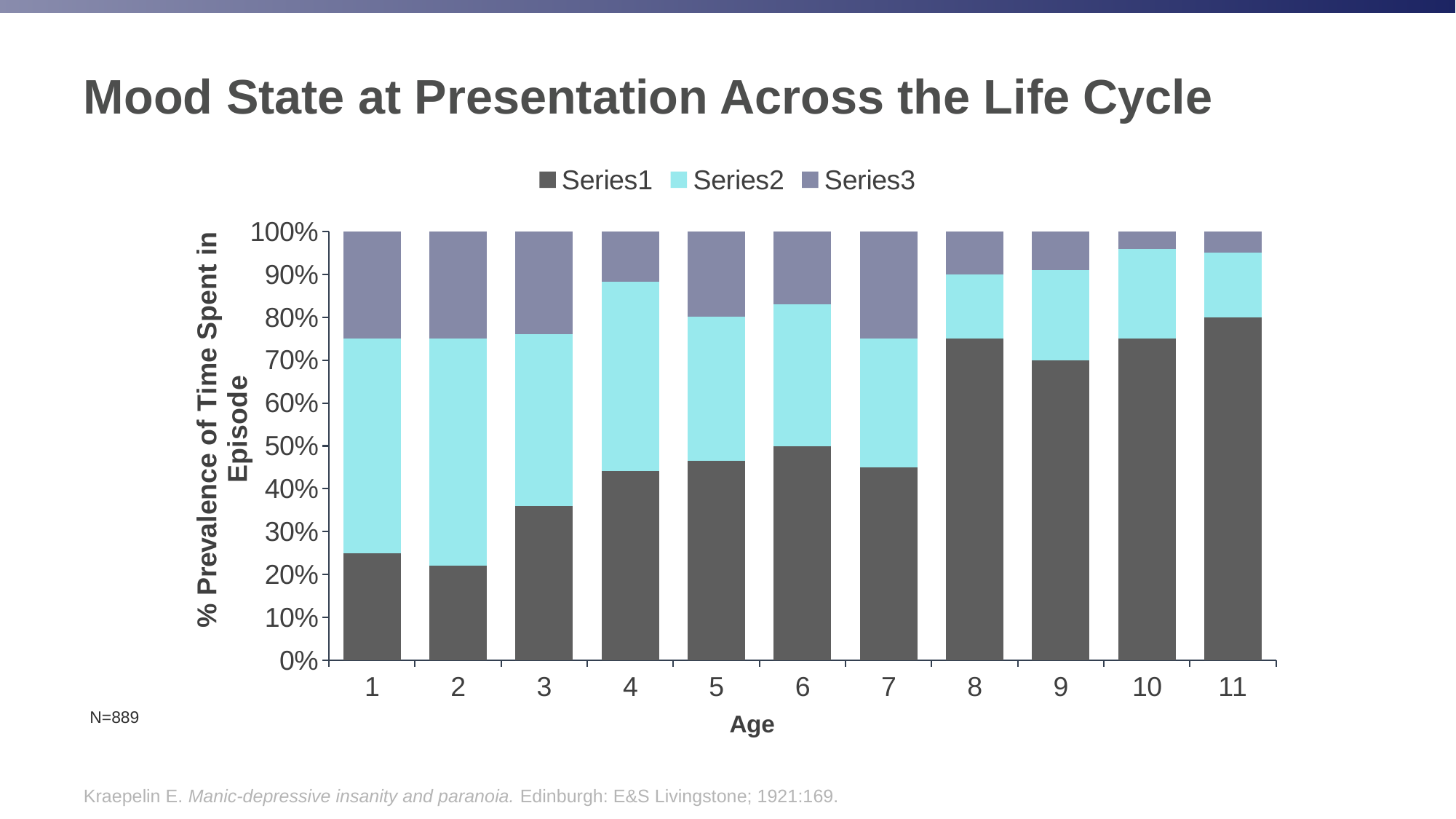
Is the Series1 value at age 8 greater or less than 70%? greater What is the title of the x axis? Age What is the total height of each stacked bar? 100% Which is larger, the Series1 value at age 8 or at age 1? Age 8 Which is larger, the Series3 segment at age 7 or at age 11? Age 7 Which age has the highest Series1 value? 11 Does the Series1 value generally rise or fall as age increases from 1 to 11? Rise How many age categories are shown on the x axis? 11 Is the Series1 value at age 1 greater or less than 30%? less How many series does the legend list? 3 What kind of chart is shown on the slide? Stacked bar chart Is the Series1 value at age 4 greater or less than 50%? less